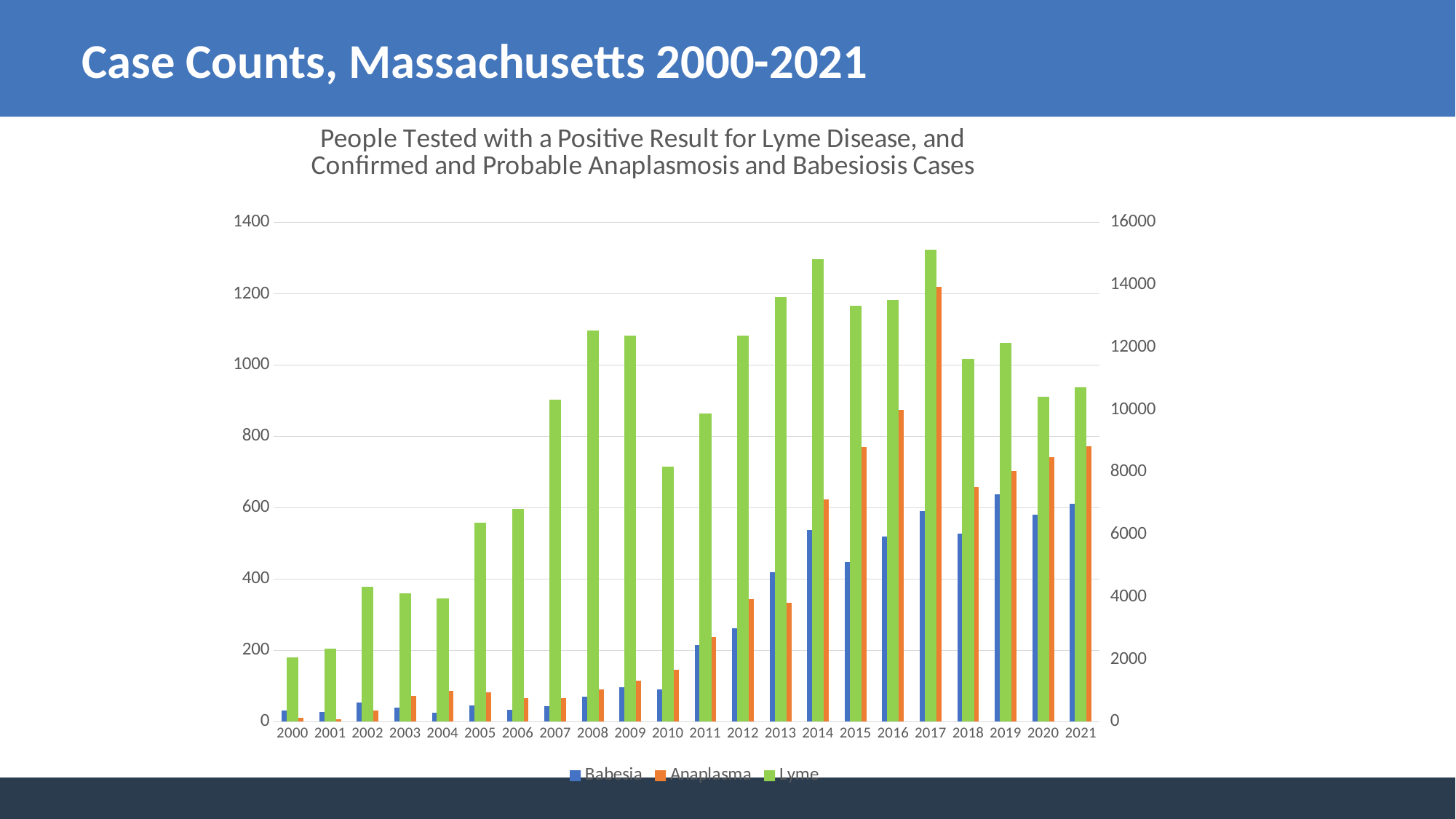
Is the Lyme value for 2008 greater or less than 12000 on the right-hand axis? greater Is the Babesia value for 2012 greater or less than 400? less Is the Anaplasma value for 2017 greater or less than 1000? greater Which year has the highest Anaplasma value? 2017 How many series does the legend list? 3 What kind of chart is shown on the slide? Bar chart Which series is shown in green? Lyme Which is larger, the Lyme value for 2014 or the Lyme value for 2015? 2014 Which year has the highest Babesia value? 2019 How many years are shown along the x axis? 22 Does the Anaplasma series rise or fall from 2018 to 2021? rise Which year has the lowest Lyme value? 2000